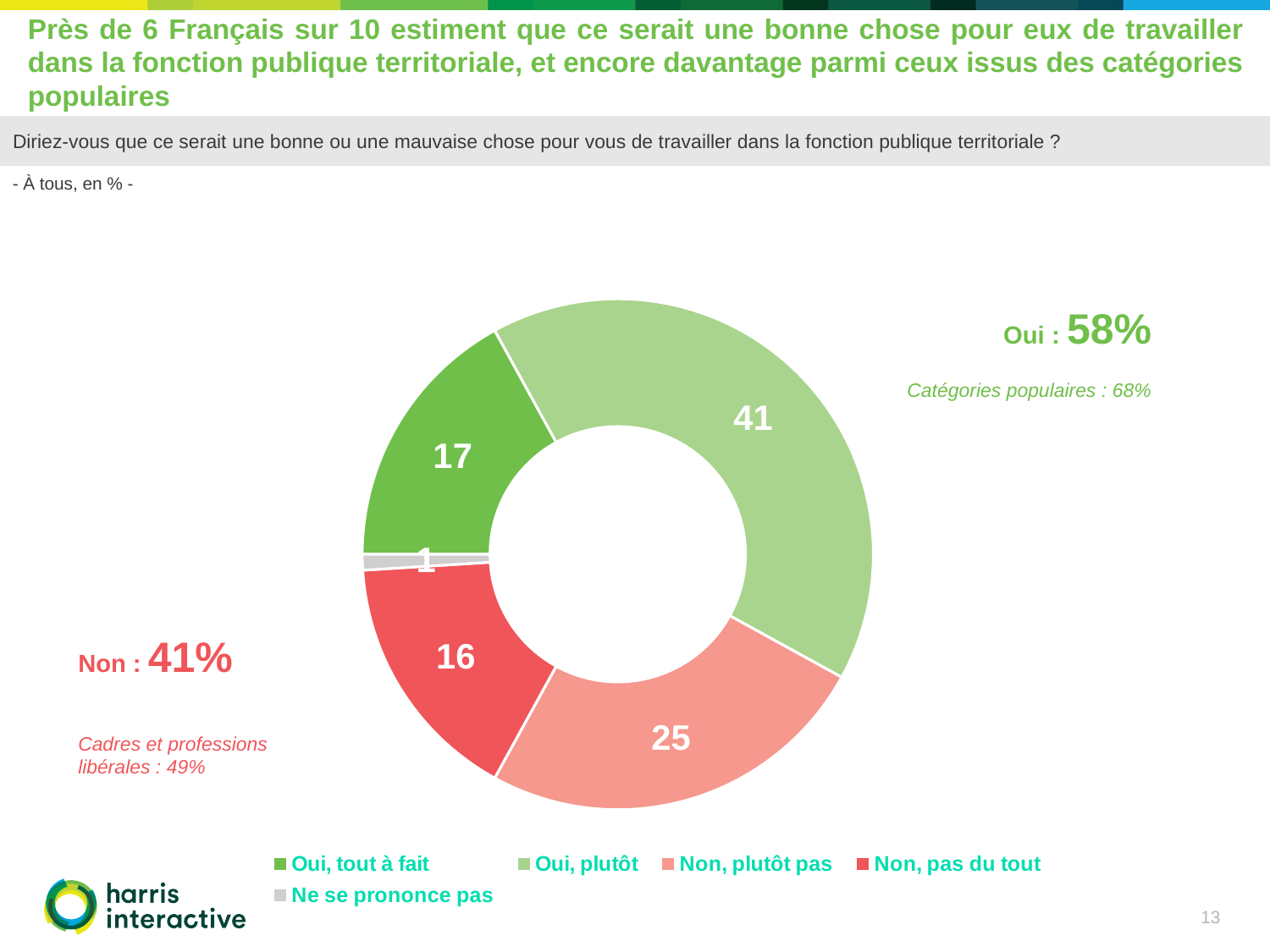
What total percentage is shown for "Oui" next to the chart? 58% What is the value for "Oui, tout à fait"? 17 Which category has the highest value? Oui, plutôt What is the value for "Oui, plutôt"? 41 What is the value for "Non, plutôt pas"? 25 Which is larger, "Oui, tout à fait" or "Non, pas du tout"? Oui, tout à fait What is the difference between "Oui, plutôt" and "Non, plutôt pas"? 16 How many categories does the legend list? 5 What is the value for "Ne se prononce pas"? 1 Which category has the lowest value? Ne se prononce pas What is the value for "Non, pas du tout"? 16 What kind of chart is shown on the slide? Pie chart (donut)